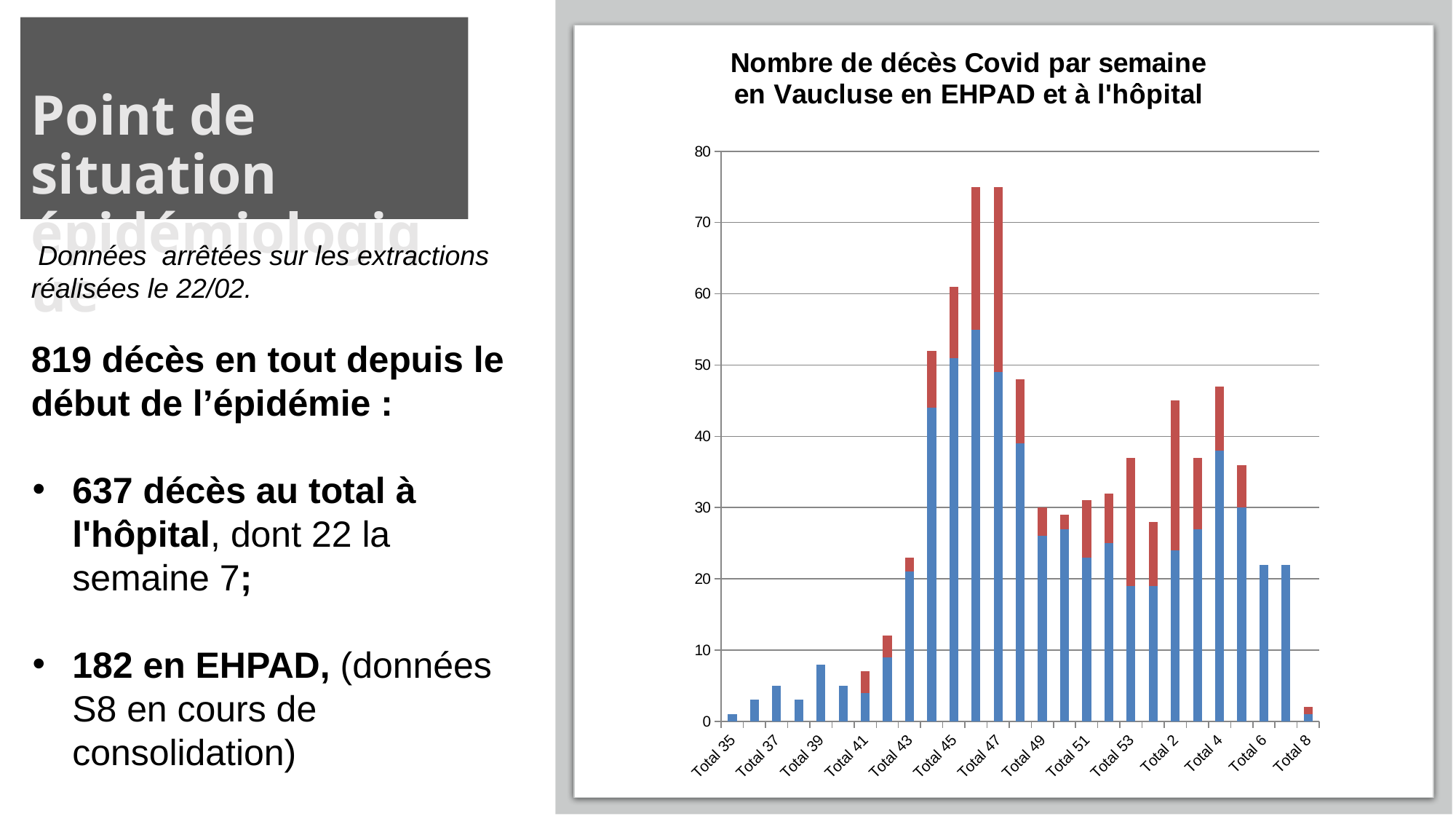
Is the total value for Total 8 greater or less than 10? less Is the total value for Total 43 greater or less than 30? less Is the total value for Total 6 greater or less than 30? less Which bar is taller, Total 47 or Total 43? Total 47 Do the bar totals rise or fall from Total 35 to Total 47? Rise What is the title of the chart? Nombre de décès Covid par semaine en Vaucluse en EHPAD et à l'hôpital How many bars are plotted in the chart? 27 Which bar is taller, Total 2 or Total 53? Total 2 What kind of chart is shown on the slide? Stacked bar chart